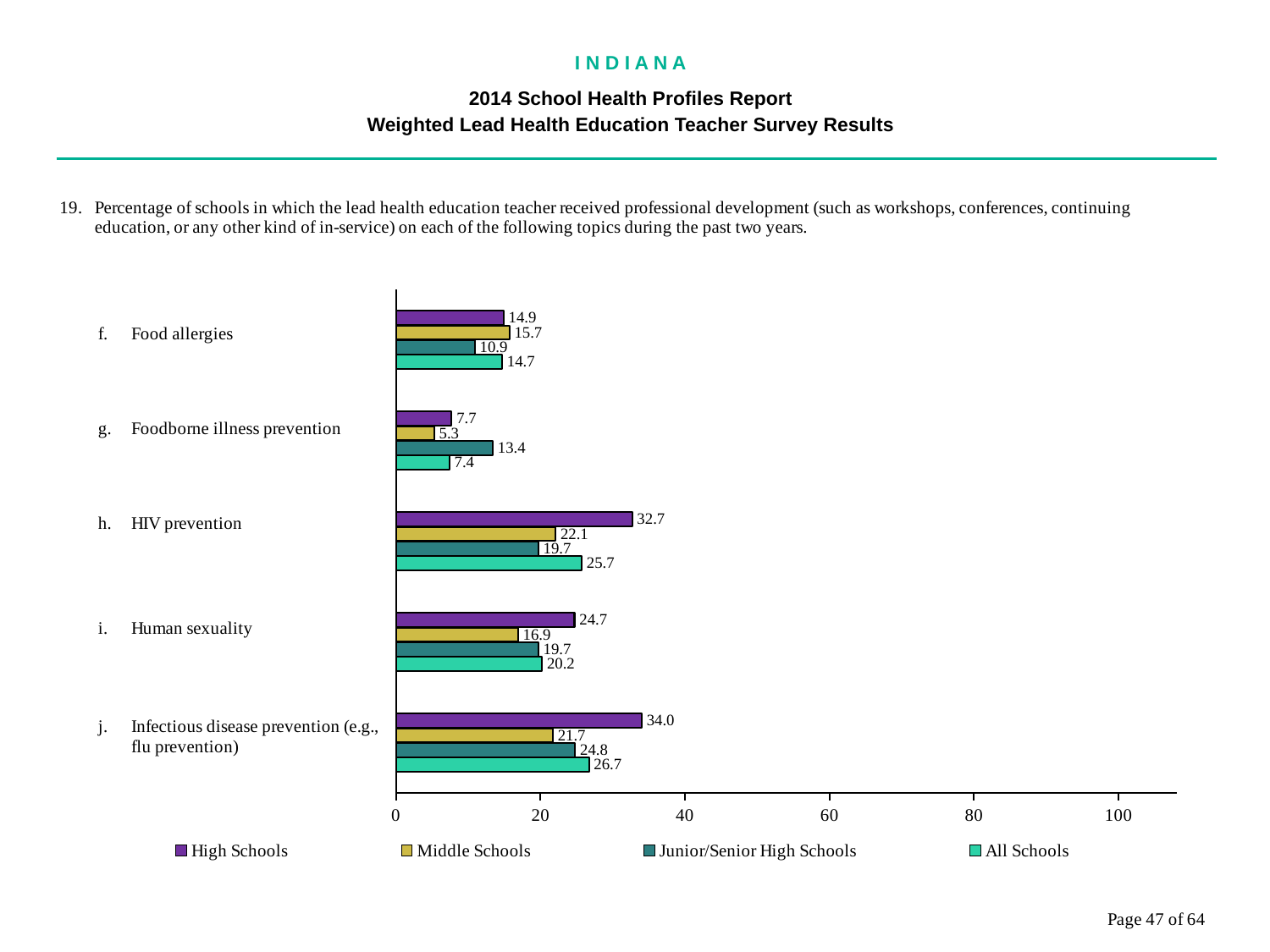
Which topic has the lowest value for All Schools? Foodborne illness prevention What is the value for Middle Schools for Foodborne illness prevention? 5.3 Which topic has the highest value for High Schools? Infectious disease prevention (e.g., flu prevention) How many topics are shown on the chart? 5 For Foodborne illness prevention, which is larger: the Junior/Senior High Schools value or the High Schools value? Junior/Senior High Schools What is the value for Junior/Senior High Schools for Food allergies? 10.9 What is the difference between the High Schools and Middle Schools values for Human sexuality? 7.8 How many series does the legend list? 4 Is the value for High Schools for Infectious disease prevention greater or less than 40? less What kind of chart is shown on the slide? bar chart What is the value for High Schools for HIV prevention? 32.7 What is the value for All Schools for Infectious disease prevention (e.g., flu prevention)? 26.7